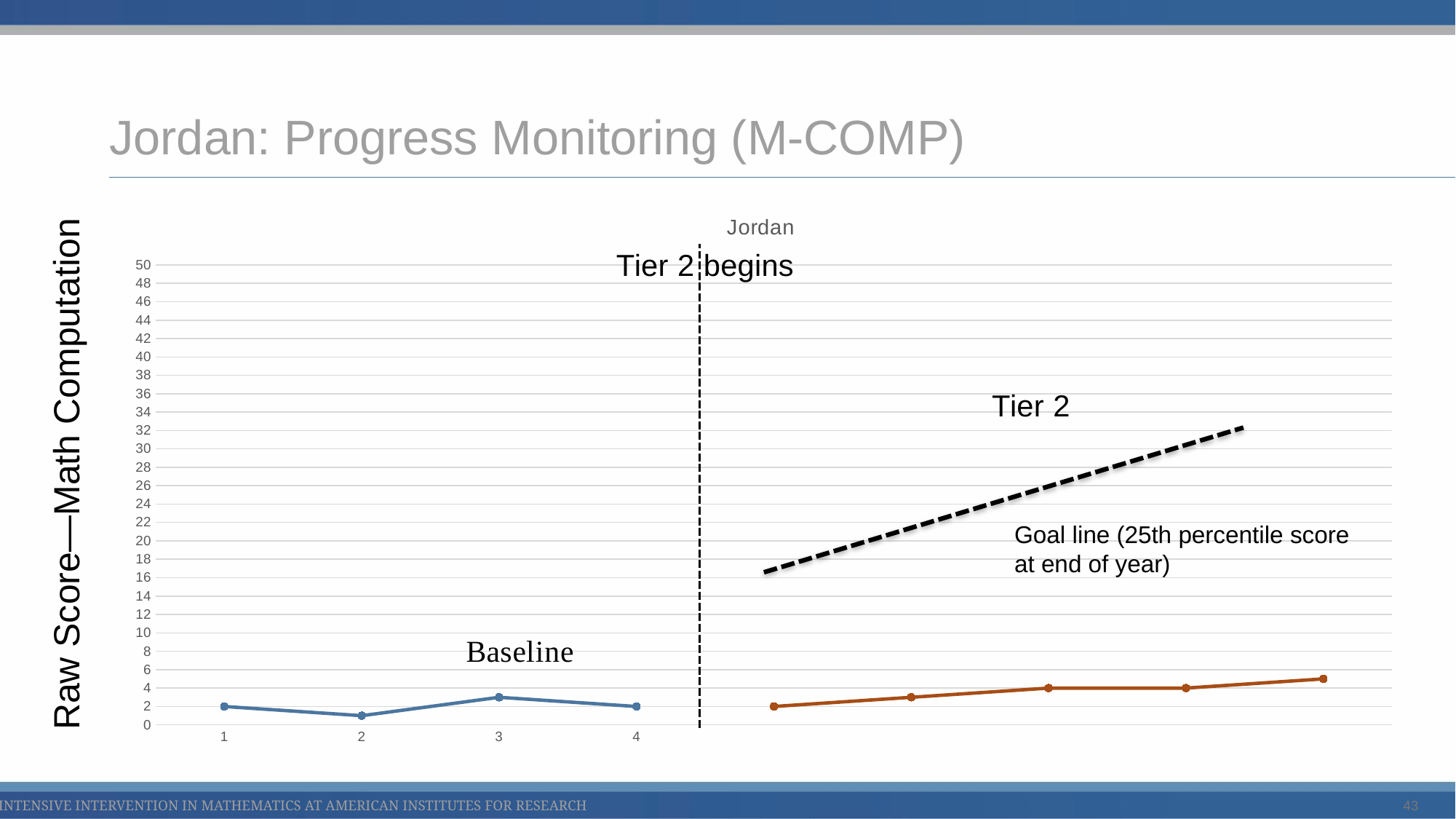
Is the Baseline value at point 2 greater or less than 2? less How many data points are plotted in the Tier 2 phase? 5 Which Baseline point has the highest value? 3 Do the Tier 2 values generally rise or fall from left to right? rise Which Baseline point has the lowest value? 2 What kind of chart is shown on the slide? line chart What is the label on the vertical axis of the chart? Raw Score—Math Computation Is the Baseline value at point 3 greater or less than 2? greater What is the Baseline value at point 1? 2 How many data points are plotted in the Baseline phase? 4 What is the title of the chart? Jordan What is the Baseline value at point 4? 2